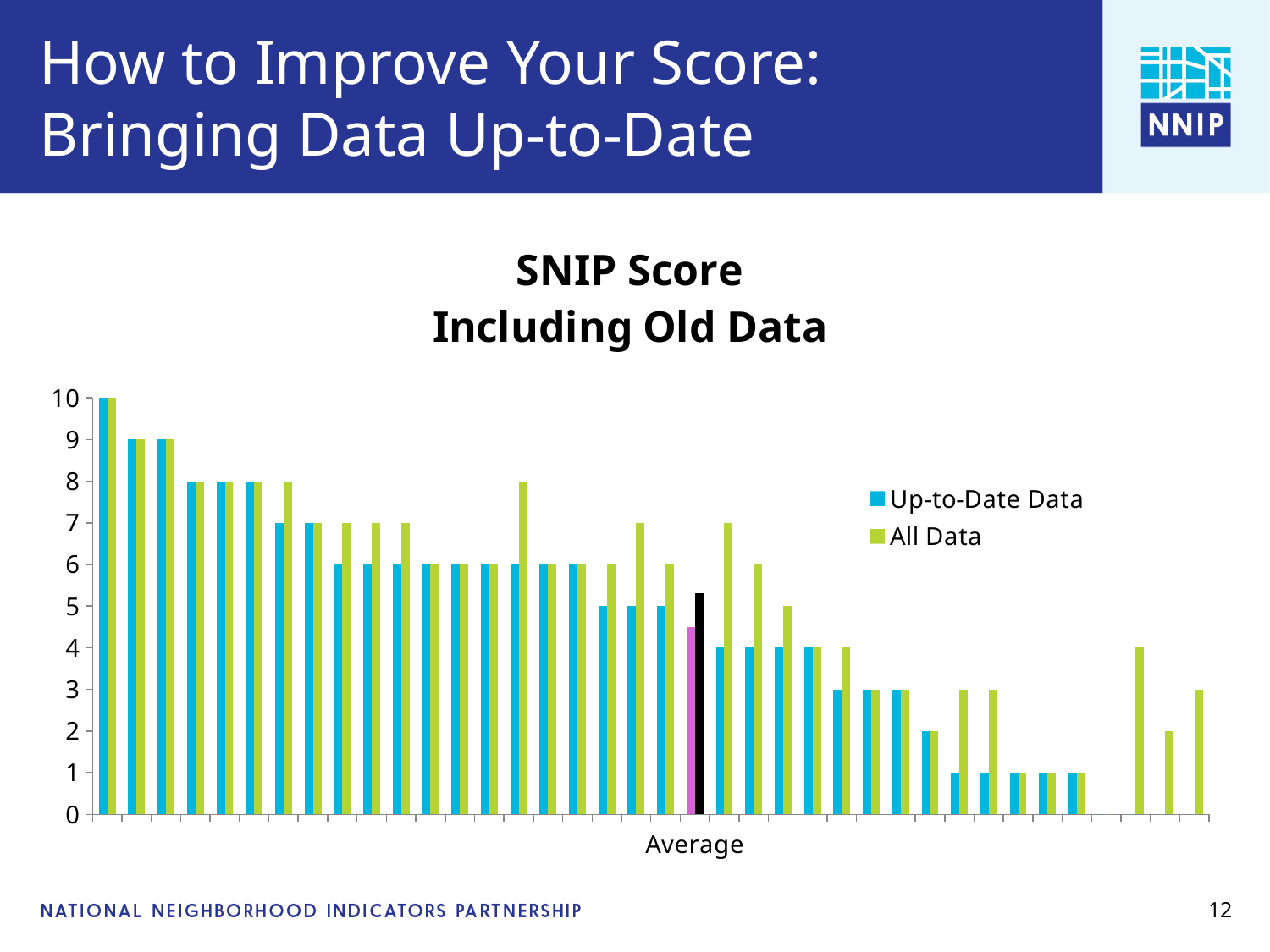
Is the Up-to-Date Data value for Average greater or less than 5? less Do the Up-to-Date Data values generally rise or fall from left to right along the x axis? fall How many series does the chart's legend list? 2 What is the title of the chart? SNIP Score Including Old Data What are the two series named in the chart's legend? Up-to-Date Data and All Data For the Average category, which is larger: the Up-to-Date Data value or the All Data value? All Data Is the All Data value for Average greater or less than 4? greater Is the Up-to-Date Data value for Average greater or less than 4? greater What kind of chart is shown on the slide? bar chart What is the highest value shown on the chart's y axis? 10